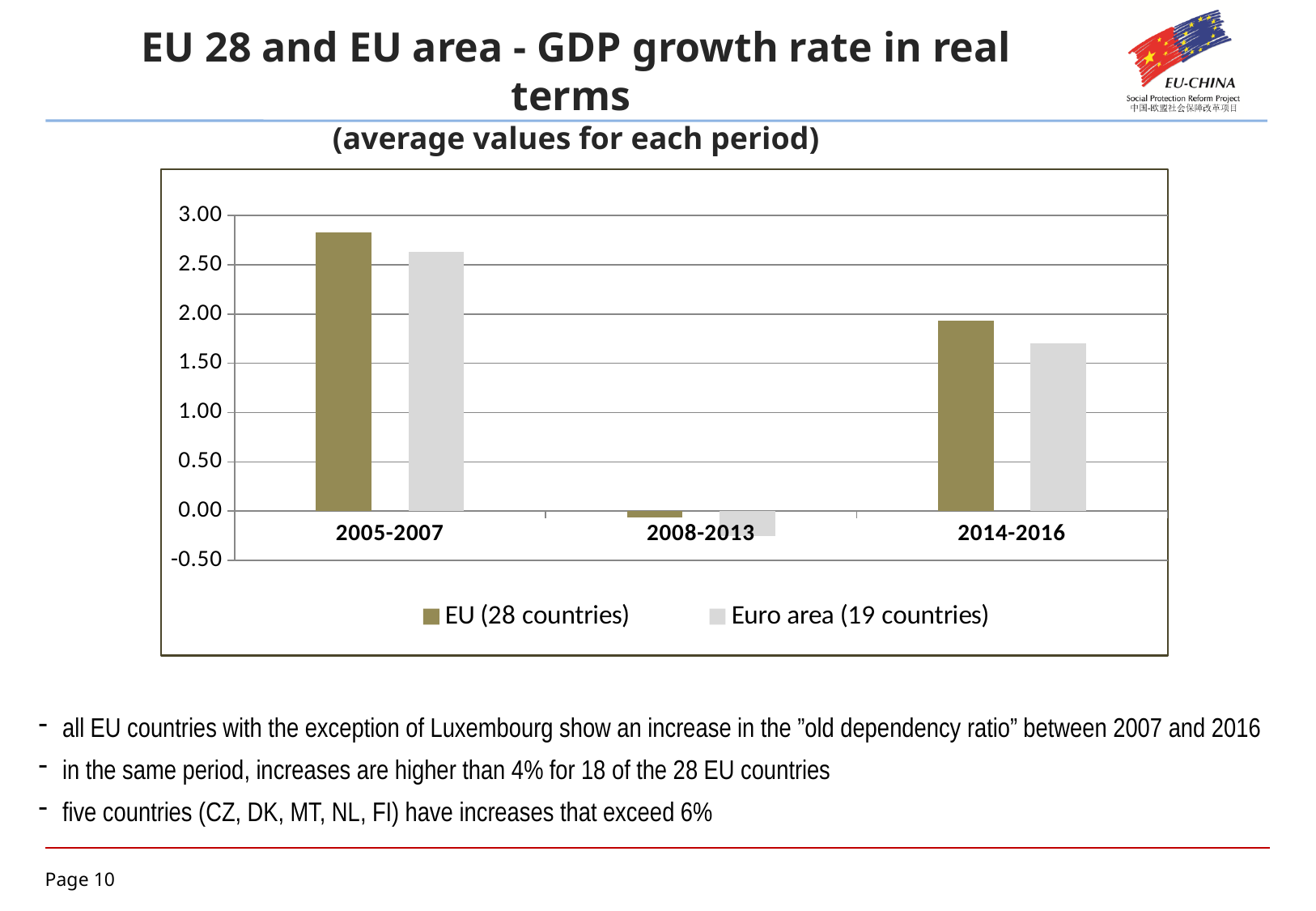
Is the value for EU (28 countries) in 2005-2007 greater or less than 2.50? greater Is the value for Euro area (19 countries) in 2014-2016 greater or less than 1.50? greater How many periods are shown on the x axis? 3 What kind of chart is shown on the slide? bar chart What is the subtitle shown above the chart? (average values for each period) Which period has the lowest value for Euro area (19 countries)? 2008-2013 Does the value for EU (28 countries) rise or fall from 2005-2007 to 2008-2013? fall In 2014-2016, which is larger: EU (28 countries) or Euro area (19 countries)? EU (28 countries) In 2005-2007, which is larger: EU (28 countries) or Euro area (19 countries)? EU (28 countries) Which period has the highest value for EU (28 countries)? 2005-2007 How many series does the legend list? 2 Is the value for Euro area (19 countries) in 2008-2013 greater or less than 0.00? less